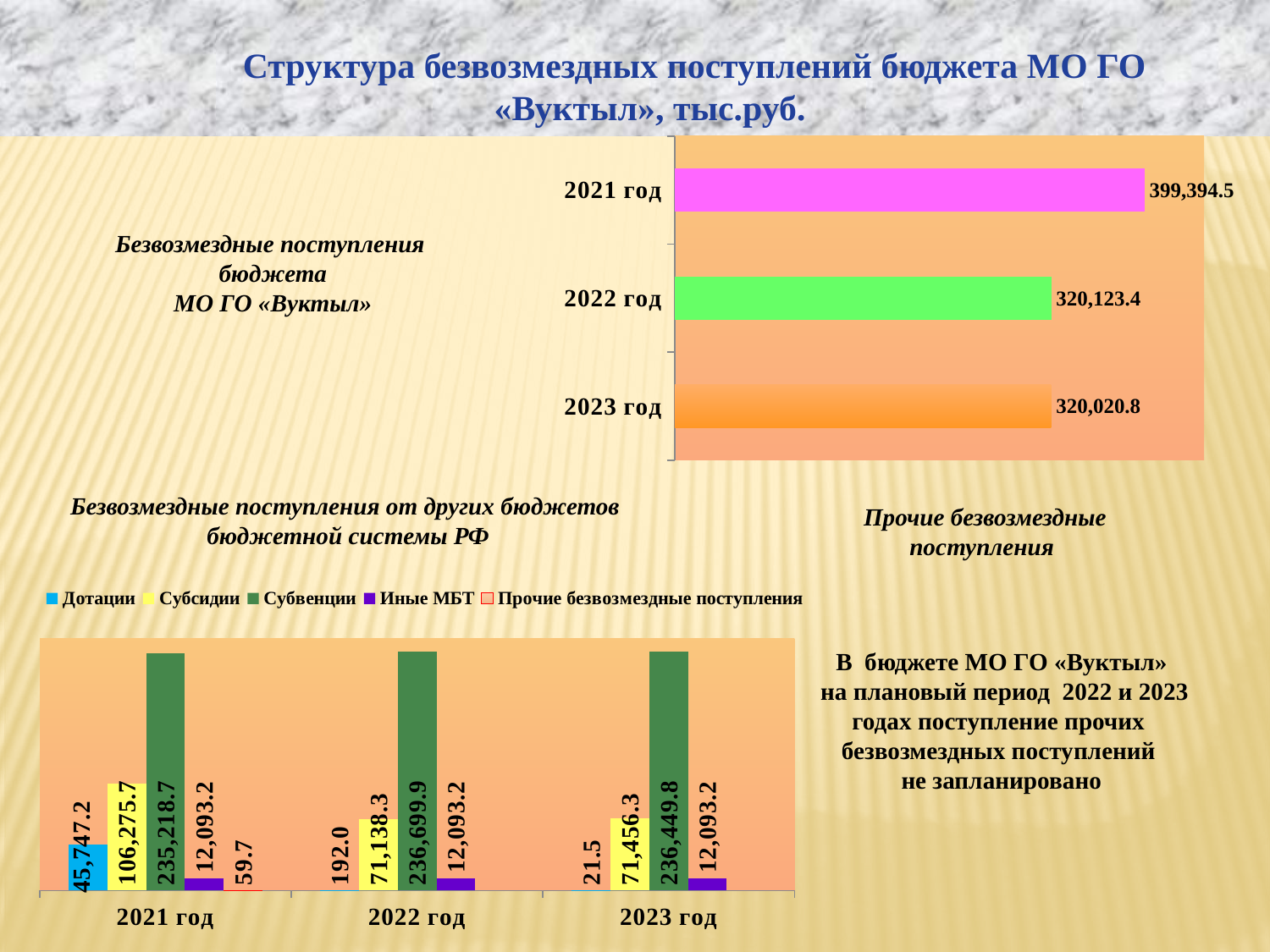
In the bottom chart (Безвозмездные поступления от других бюджетов бюджетной системы РФ), which series has the highest value in 2021 год? Субвенции What type of chart is the top chart (Безвозмездные поступления бюджета МО ГО «Вуктыл»)? Bar chart In the top chart (Безвозмездные поступления бюджета МО ГО «Вуктыл»), what is the difference between the 2021 год and 2022 год values? 79,271.1 In the bottom chart (Безвозмездные поступления от других бюджетов бюджетной системы РФ), what is the value of Субвенции for 2022 год? 236,699.9 In the top chart (Безвозмездные поступления бюджета МО ГО «Вуктыл»), which year has the highest value? 2021 год In the bottom chart (Безвозмездные поступления от других бюджетов бюджетной системы РФ), what is the value of Дотации for 2023 год? 21.5 In the top chart (Безвозмездные поступления бюджета МО ГО «Вуктыл»), how many years are shown? 3 In the bottom chart (Безвозмездные поступления от других бюджетов бюджетной системы РФ), what is the value of Субсидии for 2021 год? 106,275.7 In the top chart (Безвозмездные поступления бюджета МО ГО «Вуктыл»), what is the value for 2023 год? 320,020.8 In the top chart (Безвозмездные поступления бюджета МО ГО «Вуктыл»), what is the value for 2021 год? 399,394.5 In the bottom chart (Безвозмездные поступления от других бюджетов бюджетной системы РФ), what is the difference between Субсидии in 2021 год and 2022 год? 35,137.4 In the bottom chart (Безвозмездные поступления от других бюджетов бюджетной системы РФ), how many series does the legend list? 5